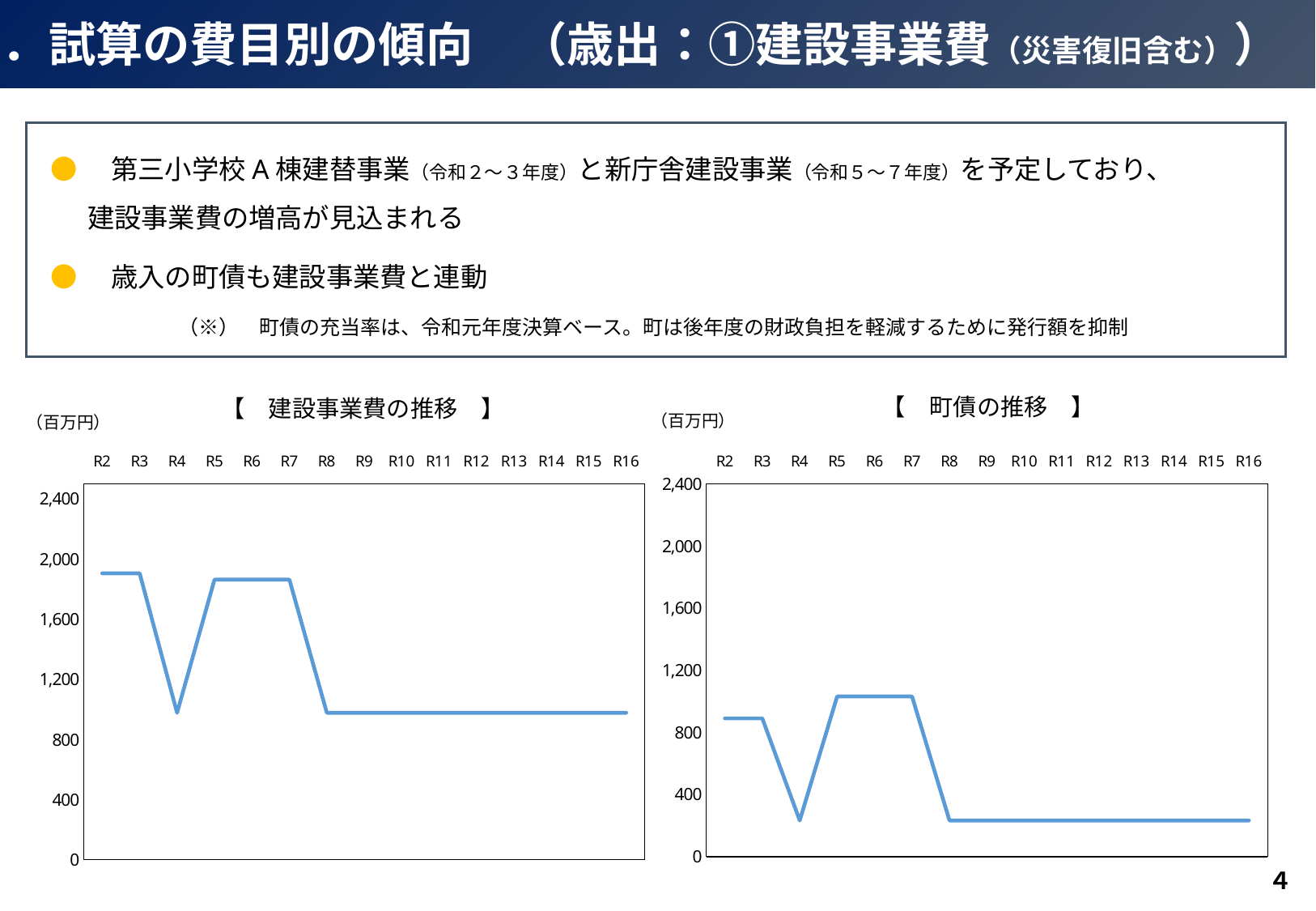
What kind of chart is the 建設事業費の推移 chart? line chart In the 町債の推移 chart, is the value for R4 greater or less than 400? less In the 建設事業費の推移 chart, is the value for R4 greater or less than 1,200? less In the 町債の推移 chart, is the value for R12 greater or less than 400? less In the 町債の推移 chart, which is larger, the value for R3 or the value for R4? R3 How many years are plotted on the x axis of the 町債の推移 chart? 15 In the 建設事業費の推移 chart, do the values rise or fall from R7 to R8? fall What kind of chart is the 町債の推移 chart? line chart How many years are plotted on the x axis of the 建設事業費の推移 chart? 15